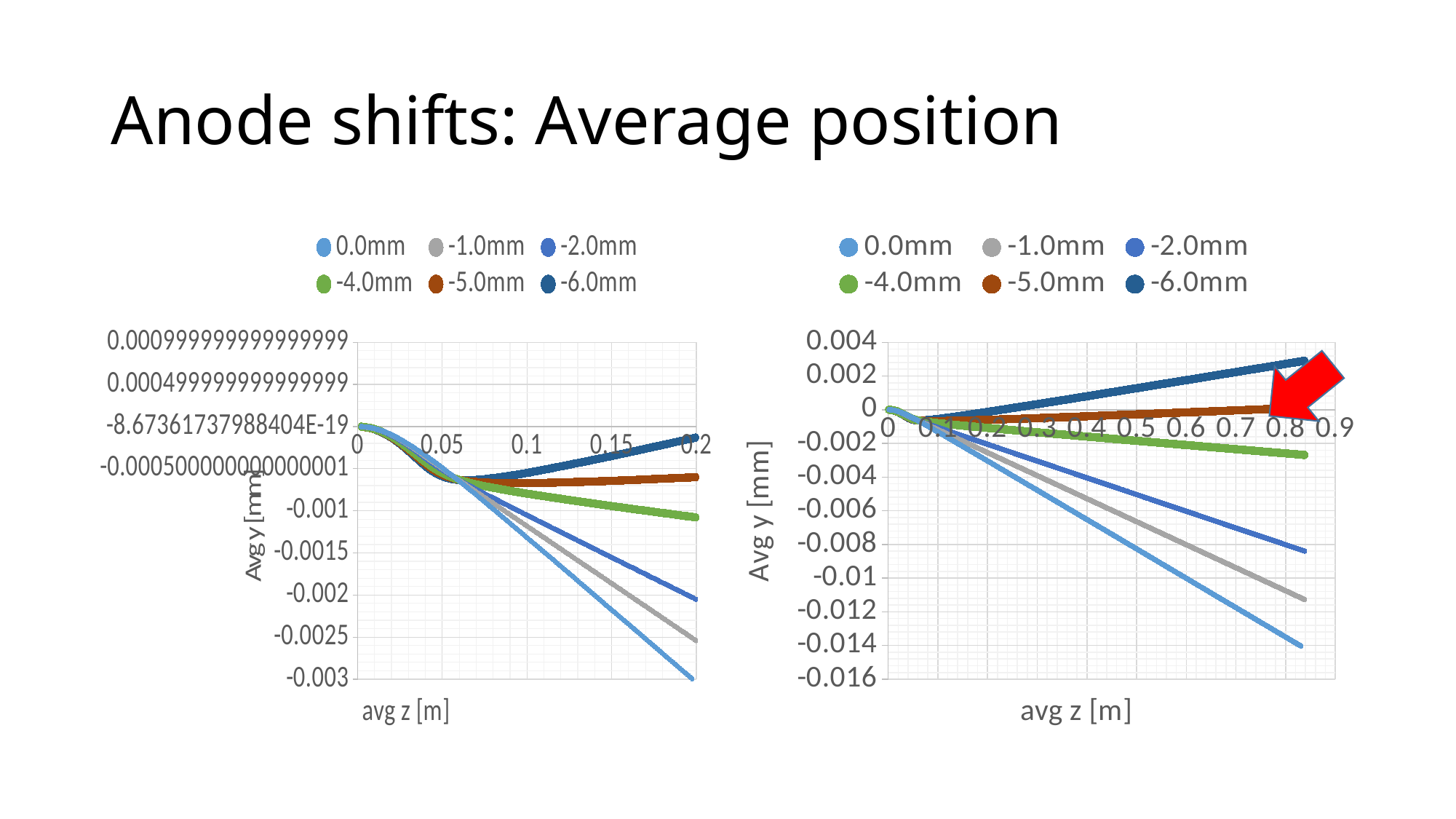
In the right chart, is the value of the -6.0mm series at avg z = 0.8 greater or less than 0.002? greater What kind of chart is the left chart on the slide? line chart In the left chart, is the value of the -1.0mm series at avg z = 0.2 greater or less than -0.002? less In the right chart, does the 0.0mm series rise or fall as avg z increases? fall How many series does the legend of the right chart list? 6 In the right chart, which series has the highest value at the right end of the x axis (avg z = 0.8)? -6.0mm What is the x-axis label of the right chart? avg z [m] In the right chart, at avg z = 0.8, which is larger: the value of the -4.0mm series or the value of the -1.0mm series? -4.0mm In the left chart, which series has the lowest value at avg z = 0.2? 0.0mm In the right chart, is the value of the 0.0mm series at avg z = 0.8 greater or less than -0.012? less In the right chart, which series has the lowest value at the right end of the x axis (avg z = 0.8)? 0.0mm